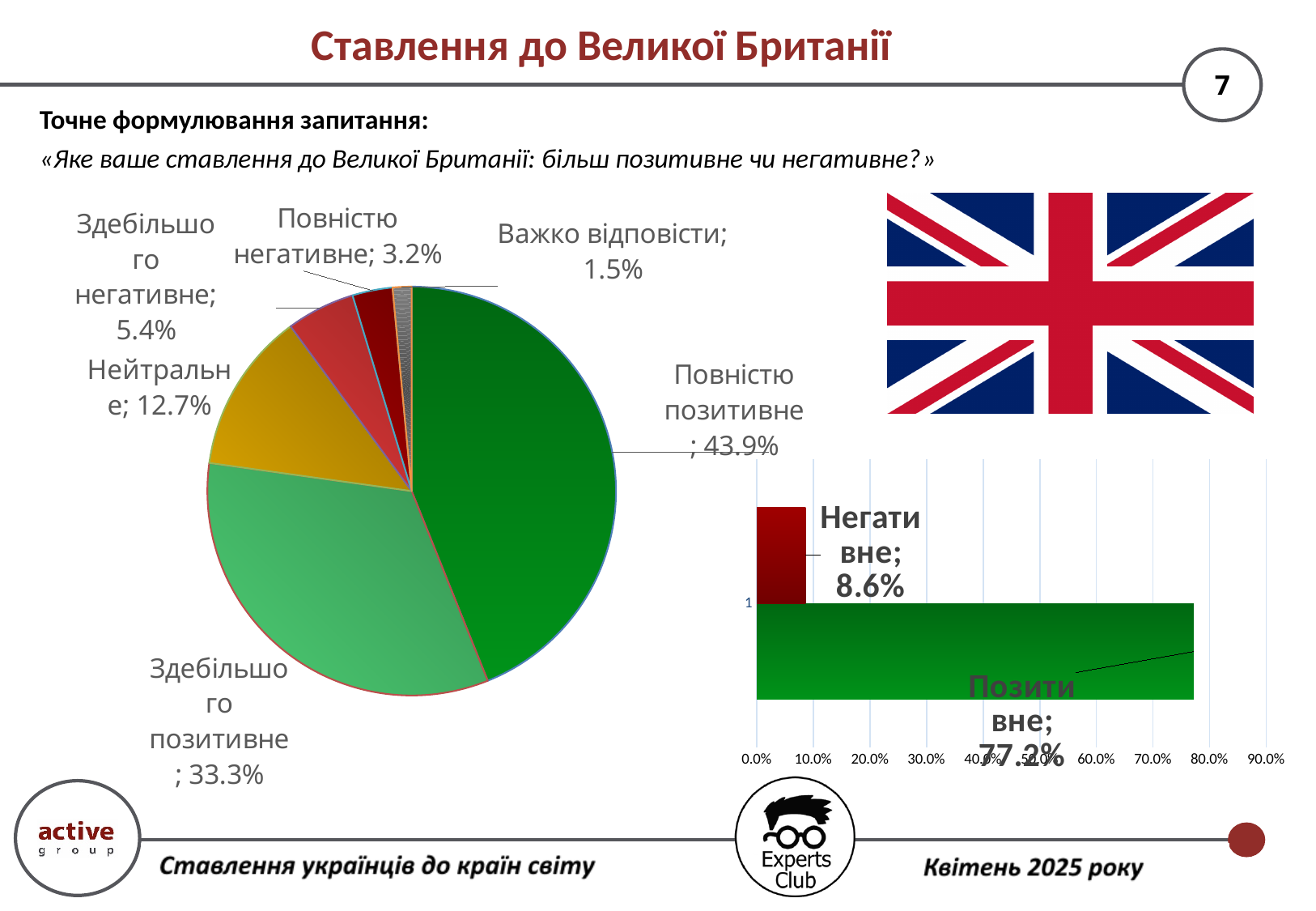
What type of chart is shown at the bottom right of the slide? Bar chart How many slices does the pie chart have? 6 In the bar chart at the bottom right, what is the difference between "Позитивне" and "Негативне"? 68.6% In the pie chart, what share is labelled for "Важко відповісти"? 1.5% In the bar chart at the bottom right, what value is labelled for "Позитивне"? 77.2% In the bar chart at the bottom right, what value is labelled for "Негативне"? 8.6% In the pie chart, what share is labelled for "Нейтральне"? 12.7% In the pie chart, what is the difference between "Повністю позитивне" and "Здебільшого позитивне"? 10.6% In the pie chart, which is larger: "Здебільшого негативне" or "Повністю негативне"? Здебільшого негативне In the pie chart, what share is labelled for "Повністю позитивне"? 43.9% In the pie chart, which category has the largest slice? Повністю позитивне In the pie chart, which category has the smallest slice? Важко відповісти